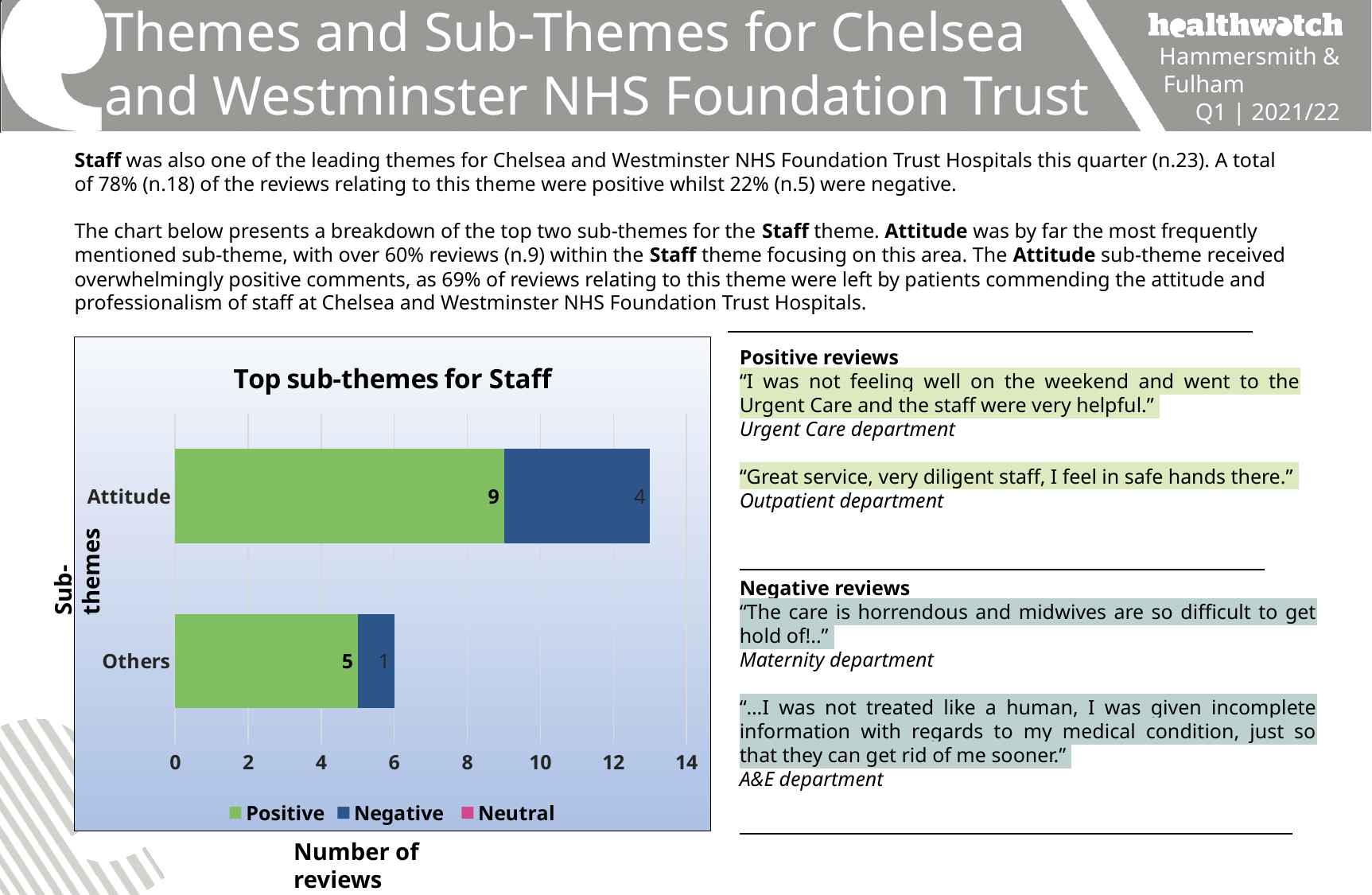
What is the Negative value for Attitude? 4 How many sub-theme categories are plotted on the chart? 2 How many series does the chart legend list? 3 What is the total number of reviews for the Attitude bar? 13 What kind of chart is shown on the slide? Stacked bar chart What is the difference between the Positive values for Attitude and Others? 4 What is the Positive value for Others? 5 Which sub-theme has the higher Negative value, Attitude or Others? Attitude What is the Positive value for Attitude? 9 What is the title of the chart? Top sub-themes for Staff What is the Negative value for Others? 1 What is the total number of reviews for the Others bar? 6